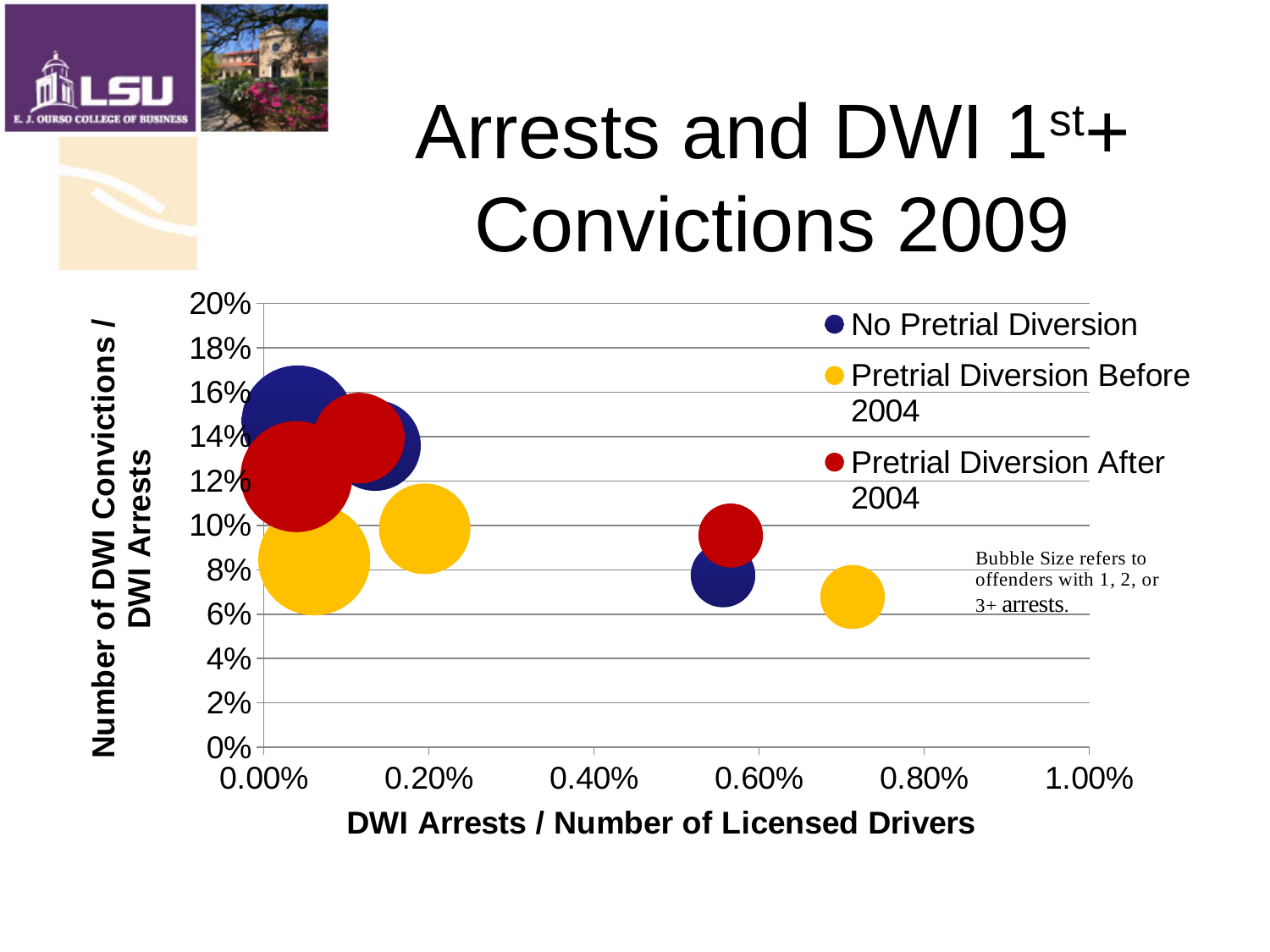
Is the vertical-axis value of the Pretrial Diversion After 2004 bubble near 0.57% on the horizontal axis greater or less than 8%? greater Is the horizontal-axis value of the rightmost Pretrial Diversion Before 2004 bubble greater or less than 0.60%? greater What is the label of the horizontal axis? DWI Arrests / Number of Licensed Drivers How many series does the legend list? 3 Is the vertical-axis value of the rightmost Pretrial Diversion Before 2004 bubble greater or less than 8%? less How many bubbles are plotted in total on the chart? 9 What kind of chart is shown on the slide? Bubble chart What is the title of the chart? Arrests and DWI 1st+ Convictions 2009 As the arrest rate on the horizontal axis increases, do the conviction rates of the bubbles generally rise or fall? fall How many bubbles belong to the No Pretrial Diversion series? 3 Which series contains the bubble with the highest conviction rate on the vertical axis? No Pretrial Diversion